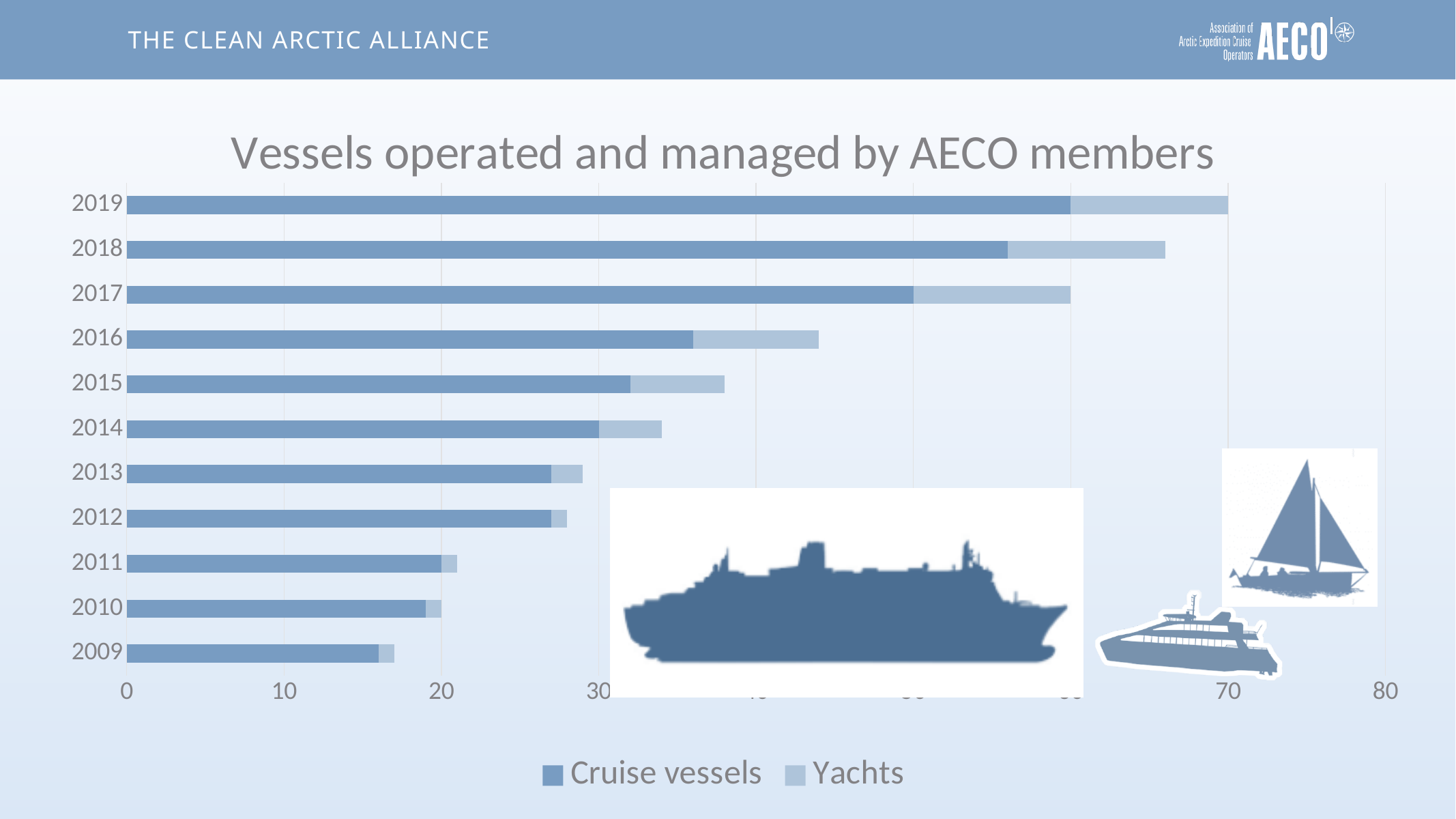
Do the total vessel numbers rise or fall from 2009 to 2019? Rise Is the total number of vessels for 2016 greater or less than 40? greater Which year has the highest total number of vessels? 2019 Which year has the lowest total number of vessels? 2009 Is the number of cruise vessels for 2015 greater or less than 30? greater Which year has a larger total number of vessels, 2018 or 2017? 2018 How many series does the legend list? 2 What is the total number of vessels for 2019? 70 What are the two series named in the legend? Cruise vessels and Yachts What kind of chart is shown on the slide? Bar chart How many years are shown on the chart? 11 Is the total number of vessels for 2013 greater or less than 30? less